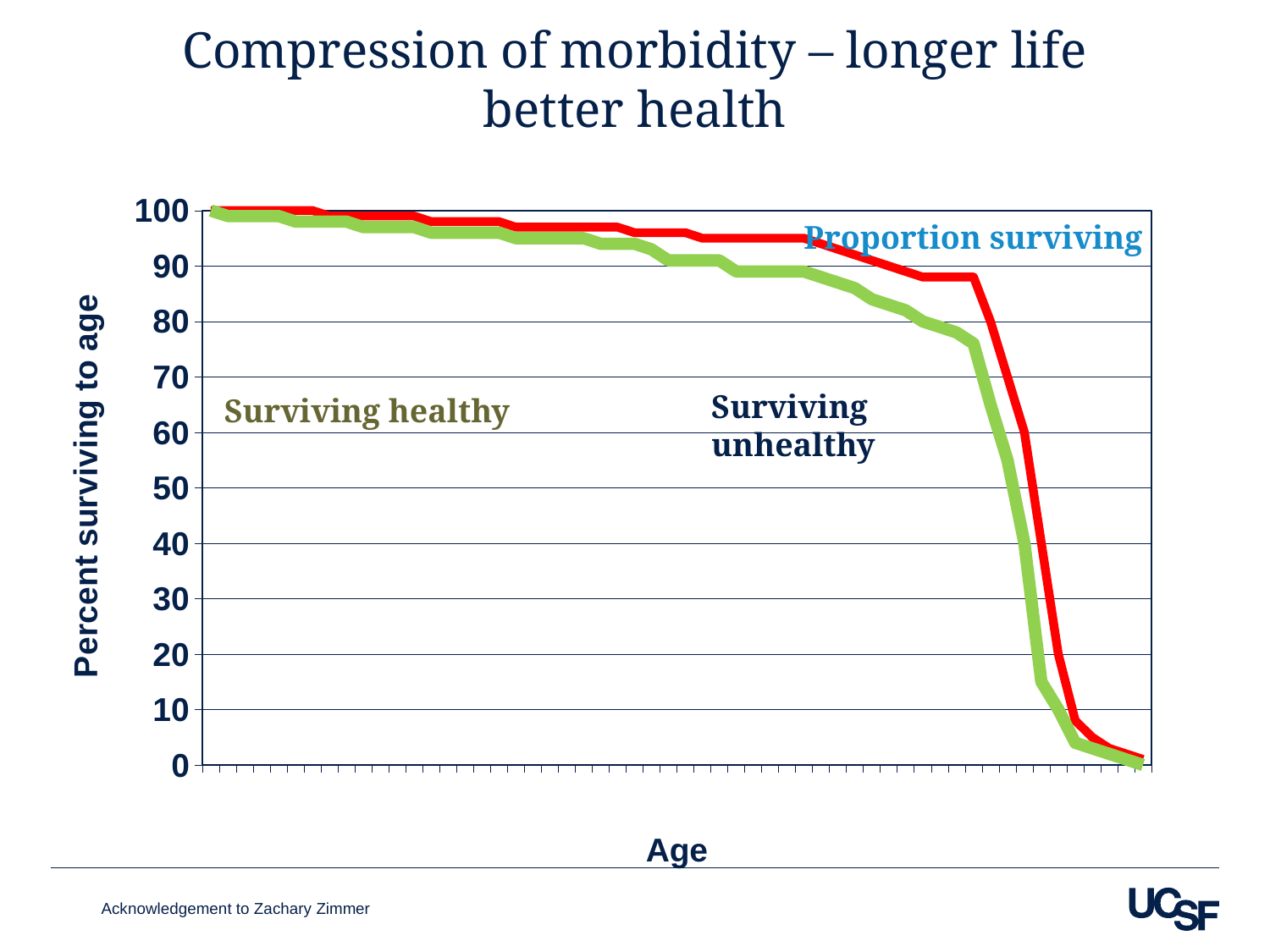
What label is given to the gap between the red and green lines? Surviving unhealthy Is the value of the red line at the right end of the chart greater or less than 10? less How many lines are plotted on the chart? 2 Do the values of the green line rise or fall as age increases along the x axis? Fall What is the title of the x axis? Age What is the highest value shown on the y axis? 100 What is the title of the y axis? Percent surviving to age Is the value of the green line at the left end of the chart greater or less than 90? greater What kind of chart is shown on the slide? Line chart Which line is higher across the chart, the red 'Proportion surviving' line or the green 'Surviving healthy' line? Proportion surviving (red) Do the values of the red line rise or fall as age increases along the x axis? Fall